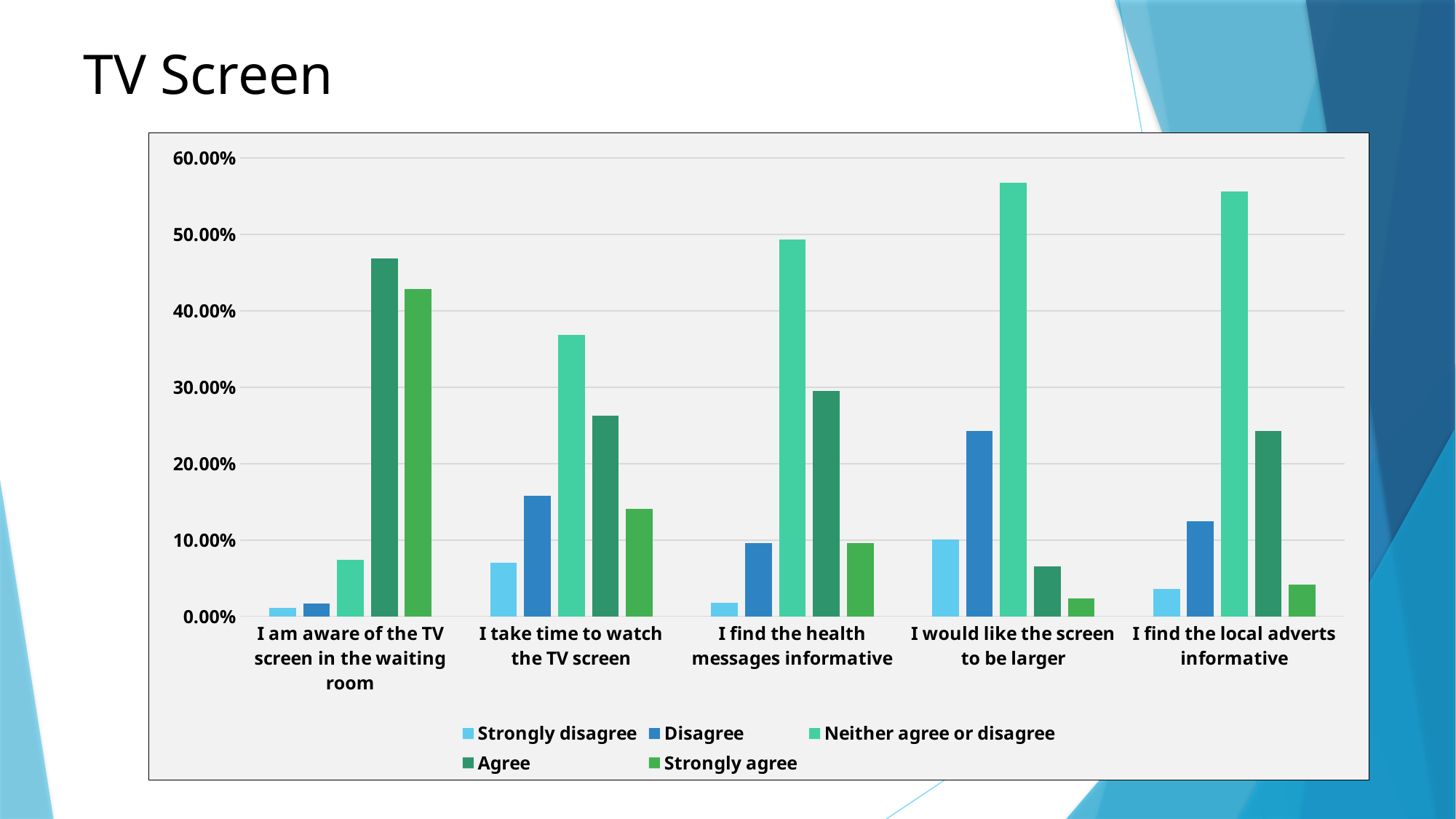
For 'I would like the screen to be larger', which response series has the highest value? Neither agree or disagree Which statement has the highest Agree value? I am aware of the TV screen in the waiting room What is the title of the slide containing the chart? TV Screen How many series does the legend list? 5 Is the Agree value for 'I am aware of the TV screen in the waiting room' greater or less than 40.00%? greater Is the Neither agree or disagree value for 'I take time to watch the TV screen' greater or less than 40.00%? less Which statement has the highest Strongly disagree value? I would like the screen to be larger How many statement categories are shown along the x axis? 5 Which has the larger Neither agree or disagree value: 'I find the health messages informative' or 'I would like the screen to be larger'? I would like the screen to be larger What kind of chart is shown on the slide? bar chart Is the Disagree value for 'I would like the screen to be larger' greater or less than 20.00%? greater For 'I take time to watch the TV screen', which is larger: Agree or Strongly agree? Agree